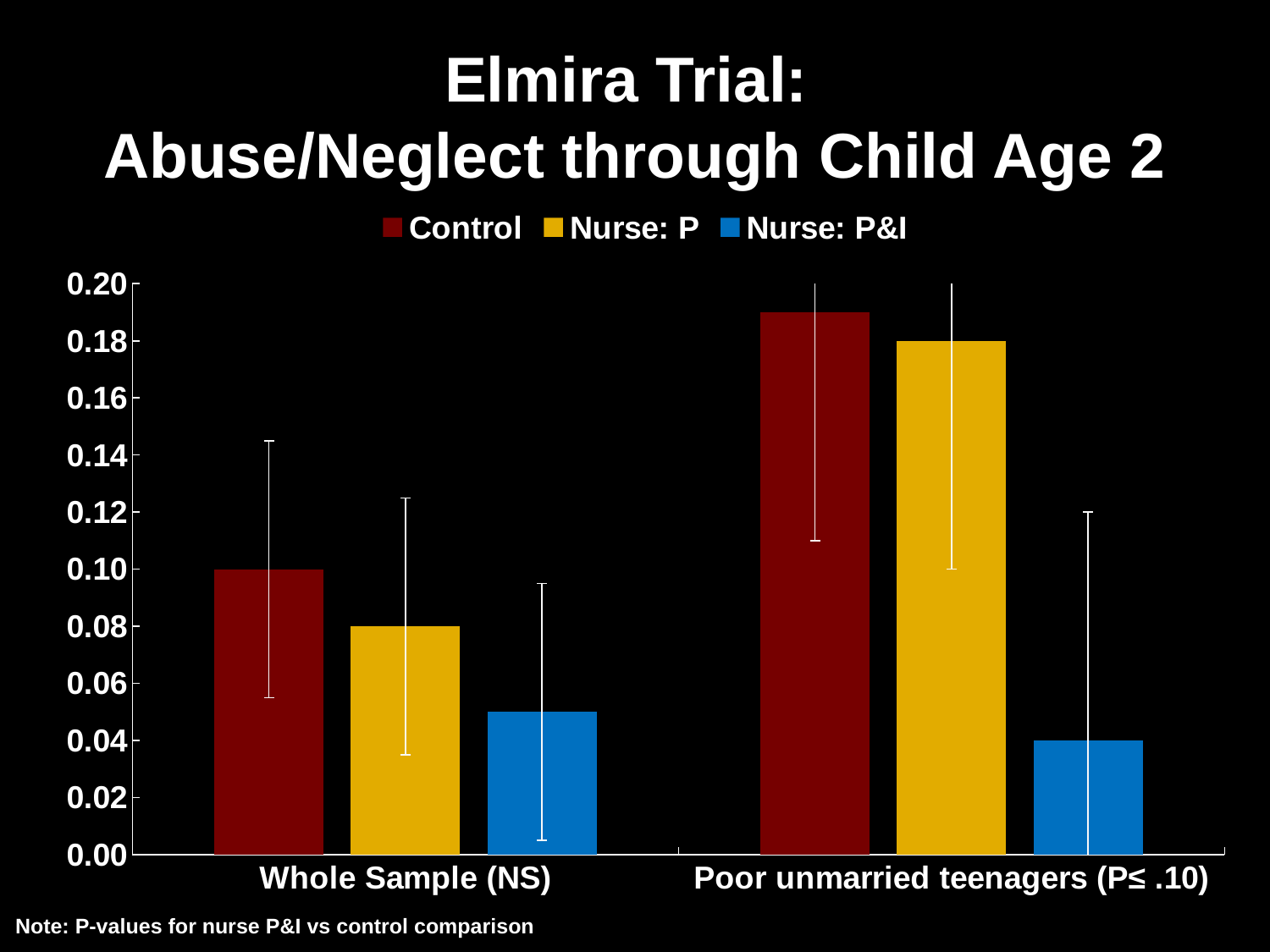
How many series does the legend list? 3 Which series has the highest bar in the Poor unmarried teenagers (P≤ .10) group? Control What is the value for Control in the Whole Sample (NS) group? 0.10 What is the value for Nurse: P in the Poor unmarried teenagers (P≤ .10) group? 0.18 What is the difference between the Nurse: P and Nurse: P&I values in the Poor unmarried teenagers (P≤ .10) group? 0.14 Is the value for Nurse: P&I in the Whole Sample (NS) group greater or less than 0.04? greater What is the value for Nurse: P in the Whole Sample (NS) group? 0.08 What kind of chart is shown on the slide? Bar chart Is the value for Control in the Poor unmarried teenagers (P≤ .10) group greater or less than 0.16? greater What is the value for Nurse: P&I in the Poor unmarried teenagers (P≤ .10) group? 0.04 In the Whole Sample (NS) group, which is larger: the Control value or the Nurse: P&I value? Control What is the difference between the Control and Nurse: P values in the Whole Sample (NS) group? 0.02